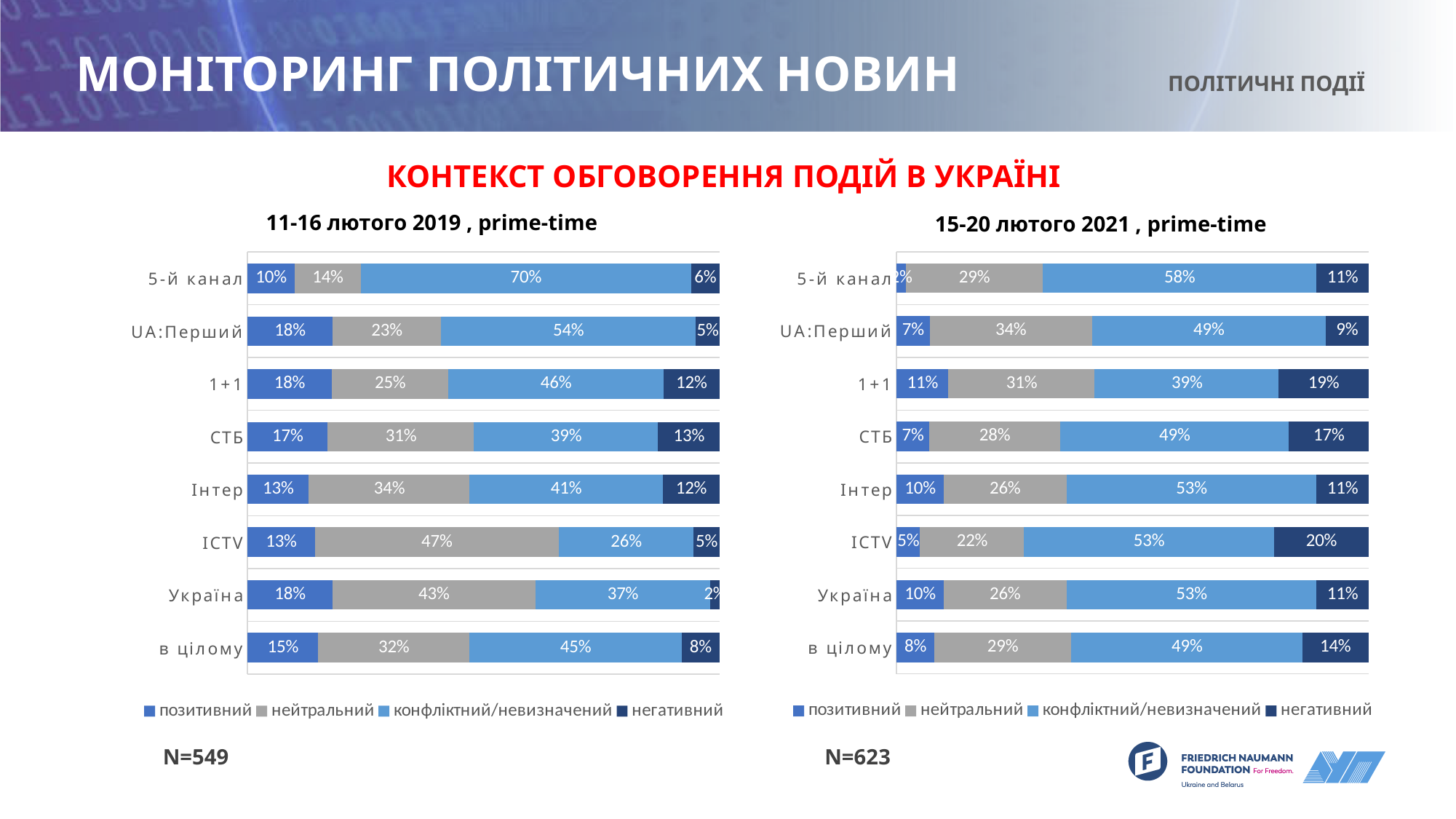
In the 2019 chart, what is the позитивний share for в цілому? 15% How many channels/categories are shown in the 2019 chart? 8 What type of chart is used for the 2019 data? Stacked bar chart In the 2019 chart, which channel has the highest конфліктний/невизначений share? 5-й канал In the 2019 chart, what is the нейтральний share for ICTV? 47% In the 2021 chart, which channel has the lowest негативний share? UA:Перший In the 2019 chart, which is larger: the нейтральний share for Україна or for Інтер? Україна In the 2021 chart, what is the позитивний share for 1+1? 11% In the 2021 chart, what is the difference between the негативний share for 1+1 and for Інтер? 8% How many series does the legend of the 2021 chart list? 4 In the 2019 chart (11-16 лютого 2019, prime-time), what is the конфліктний/невизначений share for 5-й канал? 70% In the 2021 chart (15-20 лютого 2021, prime-time), what is the негативний share for ICTV? 20%